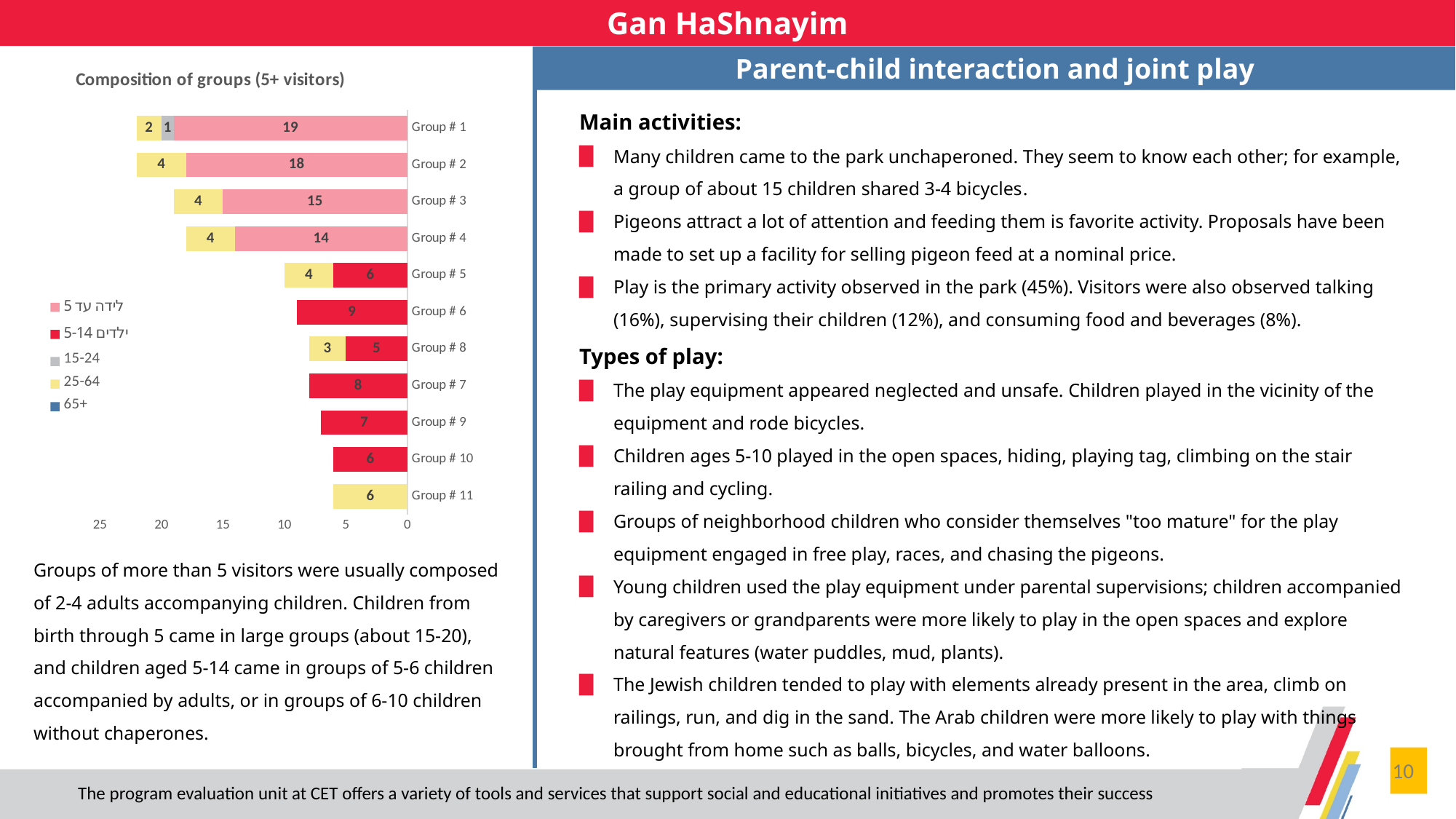
In the "Composition of groups (5+ visitors)" chart, what is the value of the red (5-14) segment for Group # 6? 9 In the "Composition of groups (5+ visitors)" chart, what is the value of the yellow (25-64) segment for Group # 8? 3 What kind of chart is shown under the title "Composition of groups (5+ visitors)"? Stacked bar chart In the "Composition of groups (5+ visitors)" chart, what is the difference between the pink (birth to 5) values of Group # 2 and Group # 4? 4 In the "Composition of groups (5+ visitors)" chart, which has the larger red (5-14) segment, Group # 7 or Group # 9? Group # 7 In the "Composition of groups (5+ visitors)" chart, which colour represents the 15-24 age group in the legend? Grey How many groups are listed as categories in the "Composition of groups (5+ visitors)" chart? 11 In the "Composition of groups (5+ visitors)" chart, which group has the smallest total bar? Group # 10 and Group # 11 (both 6) In the "Composition of groups (5+ visitors)" chart, what is the value of the pink (birth to 5) segment for Group # 1? 19 In the "Composition of groups (5+ visitors)" chart, what is the total of the stacked bar for Group # 5? 10 In the "Composition of groups (5+ visitors)" chart, what is the total of the stacked bar for Group # 1? 22 How many series does the legend of the "Composition of groups (5+ visitors)" chart list? 5